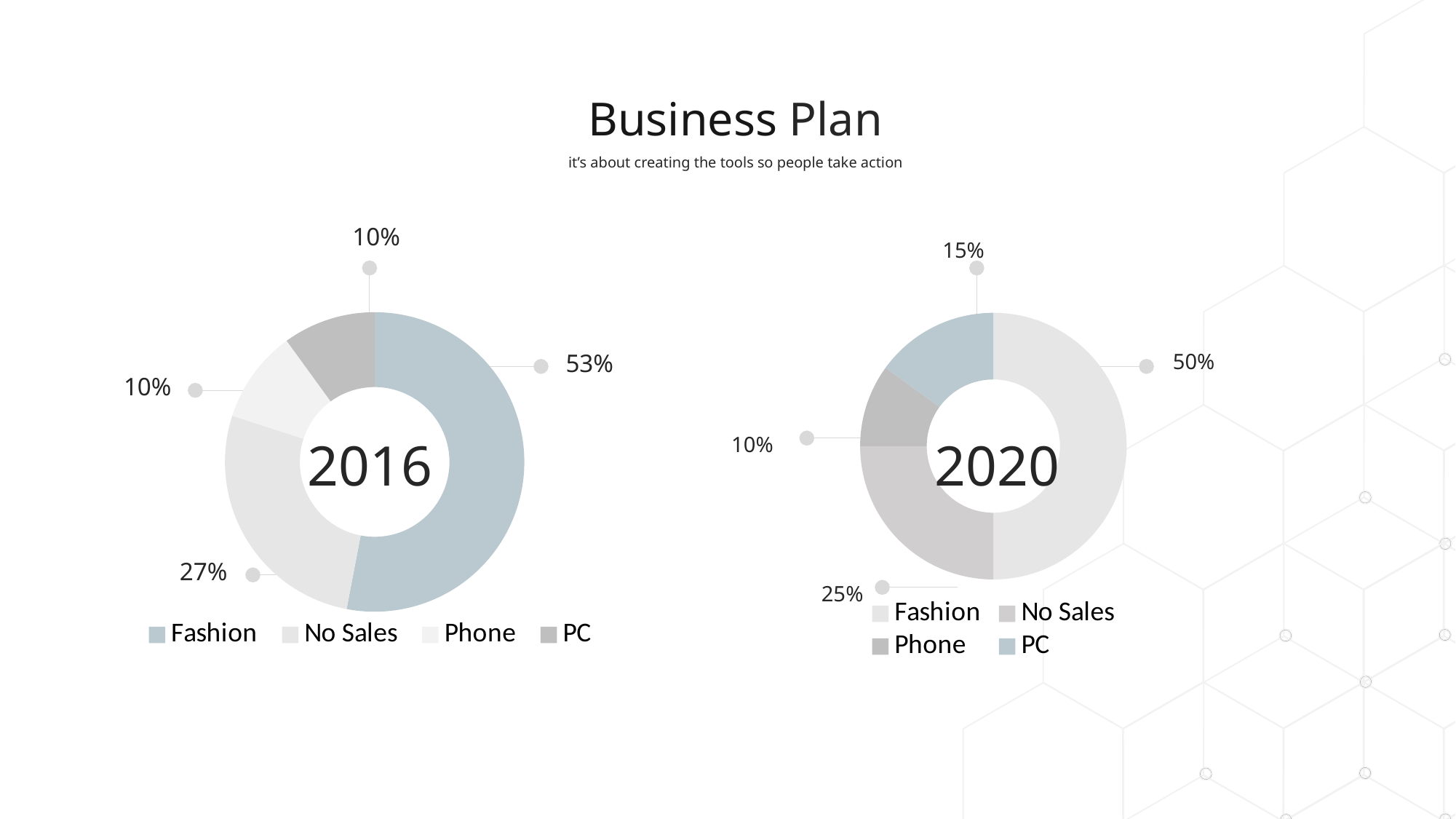
In the 2016 chart, which category has the largest share? Fashion How many categories does the legend of the 2020 chart list? 4 In the 2020 chart, which category has the smallest share? Phone In the 2016 chart, what share does Fashion have? 53% What is the title of the slide containing the two charts? Business Plan In the 2016 chart, what share does No Sales have? 27% In the 2020 chart, what share does Fashion have? 50% In the 2016 chart, what is the difference between the Fashion share and the No Sales share? 26% In the 2020 chart, which is larger, the PC share or the Phone share? PC In the 2020 chart, what share does PC have? 15% In the 2020 chart, what share does No Sales have? 25% What kind of chart is the 2016 chart? Doughnut chart